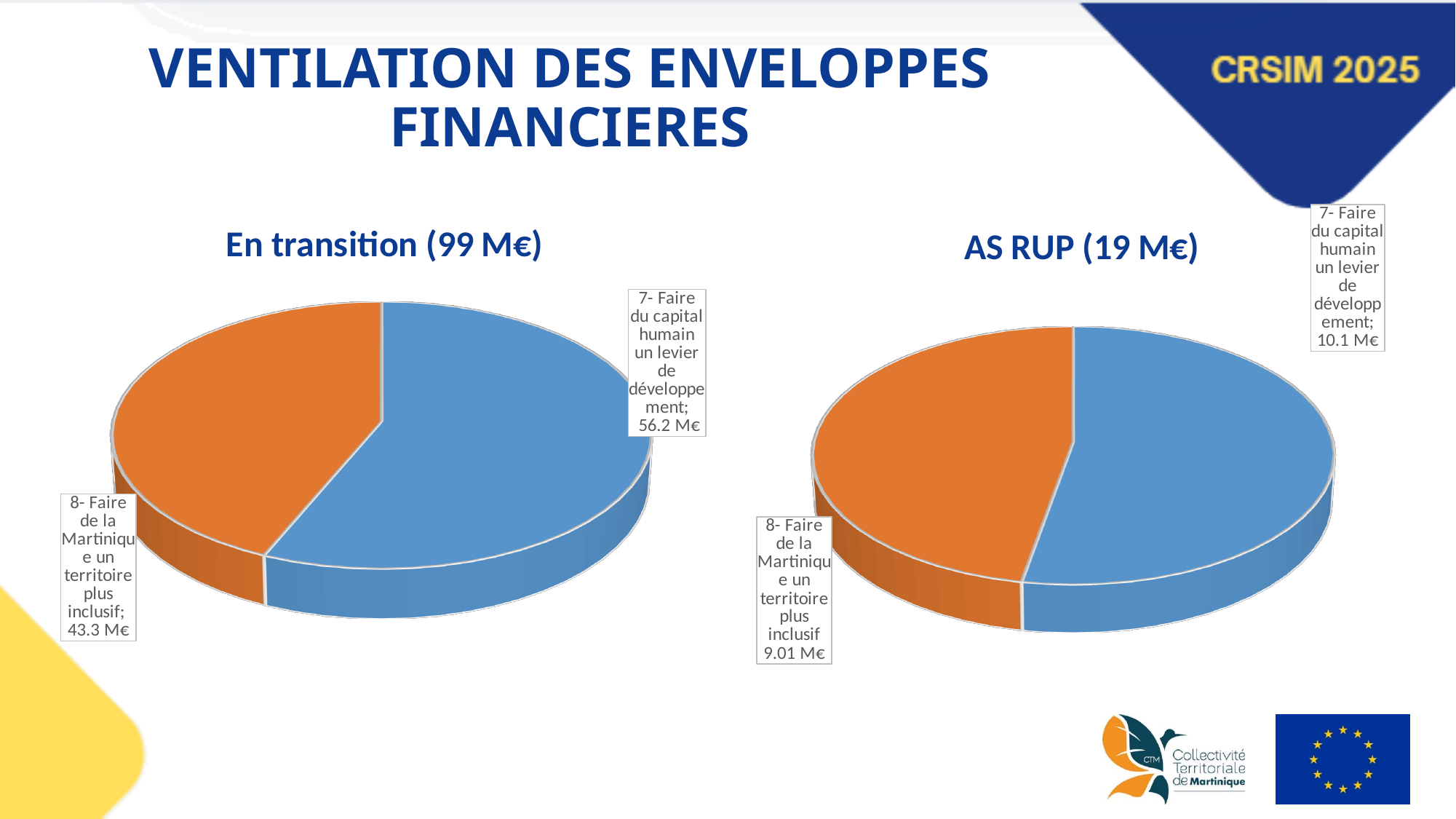
In the 'AS RUP (19 M€)' chart, what is the value for '7- Faire du capital humain un levier de développement'? 10.1 M€ In the 'En transition (99 M€)' chart, what is the value for '7- Faire du capital humain un levier de développement'? 56.2 M€ What colour is the slice for '8- Faire de la Martinique un territoire plus inclusif' in the 'En transition (99 M€)' chart? Orange In the 'En transition (99 M€)' chart, what is the difference between the two slices? 12.9 M€ In the 'AS RUP (19 M€)' chart, what is the difference between the two slices? 1.09 M€ In the 'En transition (99 M€)' chart, which slice is the largest? 7- Faire du capital humain un levier de développement In the 'AS RUP (19 M€)' chart, what is the value for '8- Faire de la Martinique un territoire plus inclusif'? 9.01 M€ In the 'AS RUP (19 M€)' chart, which slice is the smallest? 8- Faire de la Martinique un territoire plus inclusif How many slices does the 'AS RUP (19 M€)' chart have? 2 In the 'En transition (99 M€)' chart, what is the value for '8- Faire de la Martinique un territoire plus inclusif'? 43.3 M€ Is the value for '7- Faire du capital humain un levier de développement' larger in the 'En transition (99 M€)' chart or in the 'AS RUP (19 M€)' chart? En transition (99 M€) What kind of chart is the 'En transition (99 M€)' chart? Pie chart